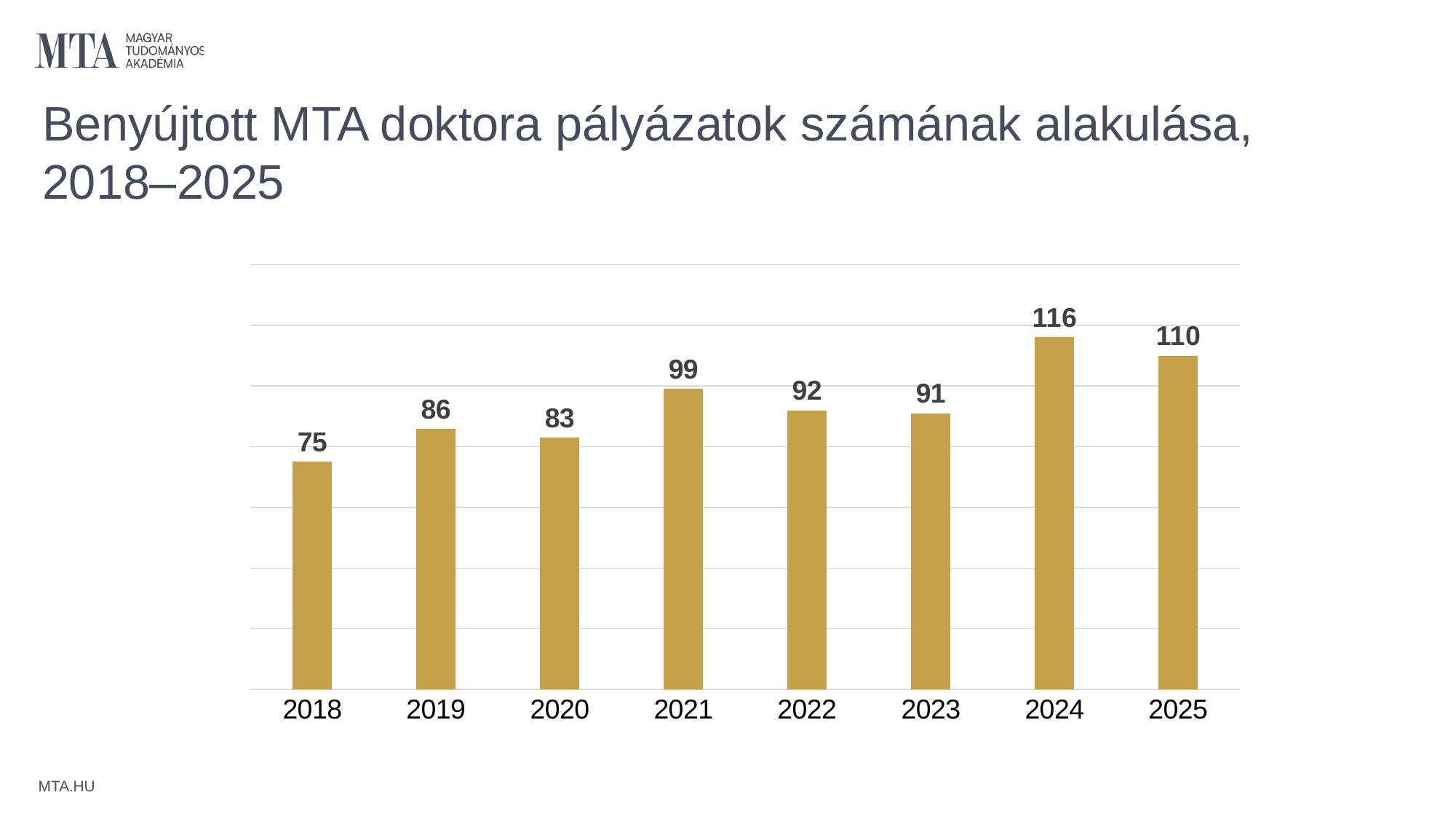
What kind of chart is shown on the slide? bar chart What is the value for 2018? 75 What is the difference between the values for 2024 and 2025? 6 What is the value for 2025? 110 What is the difference between the values for 2021 and 2018? 24 What is the title of the slide? Benyújtott MTA doktora pályázatok számának alakulása, 2018–2025 Does the value rise or fall from 2023 to 2024? rise Which year has the lowest value? 2018 How many years are shown on the x axis? 8 What is the value for 2021? 99 Which year has the highest value? 2024 Which is larger, the value for 2019 or the value for 2020? 2019